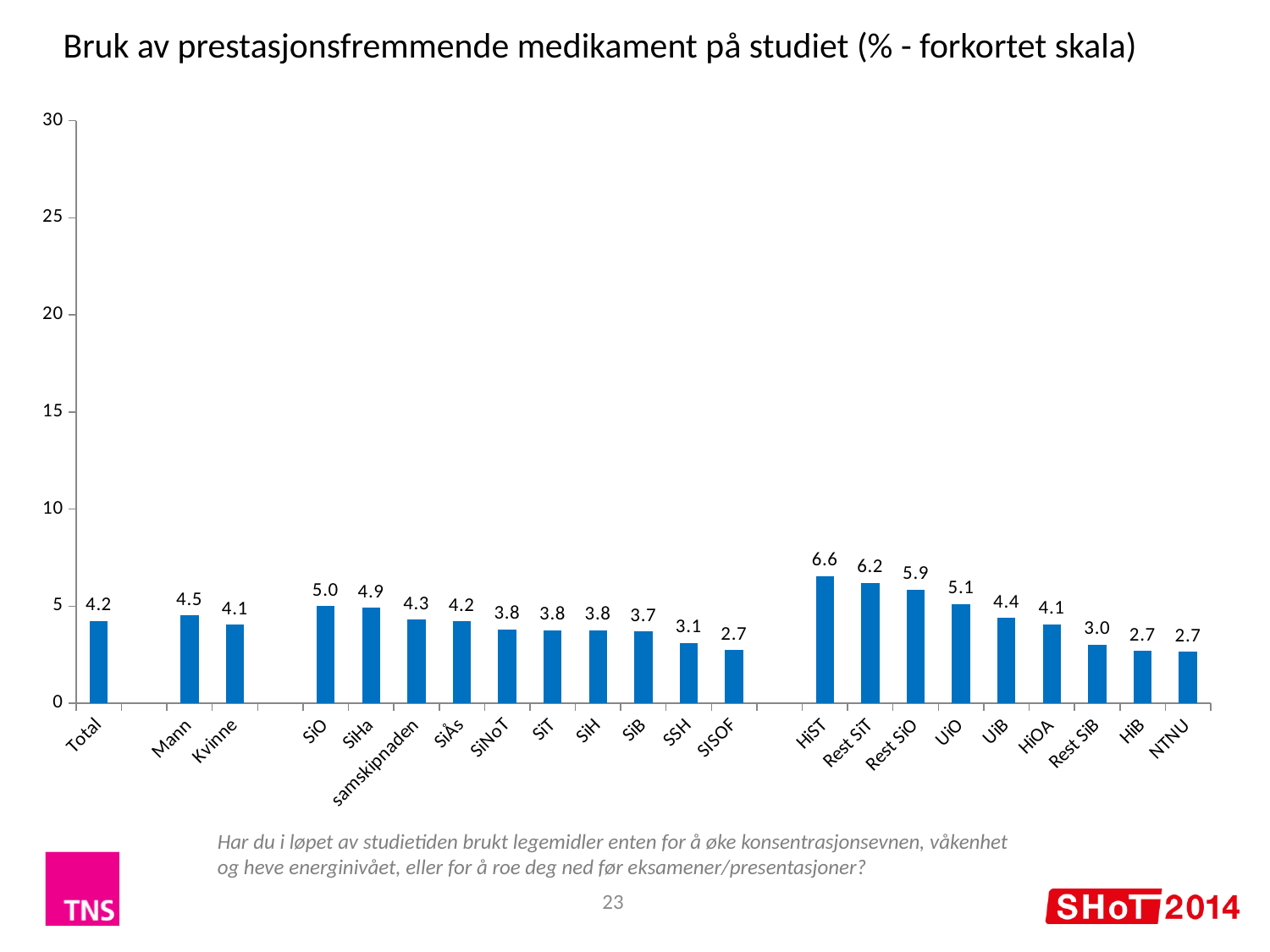
Which category has the highest value? HiST What is the difference between the values for HiST and NTNU? 3.9 What is the value for HiST? 6.6 What is the value for Rest SiB? 3.0 What kind of chart is shown on the slide? Bar chart Which is larger, the value for UiO or the value for UiB? UiO Is the value for Rest SiT greater or less than 5? greater What is the value for Total? 4.2 What is the difference between the values for Mann and Kvinne? 0.4 How many categories are shown on the x axis? 22 Which is larger, the value for SSH or the value for SiHa? SiHa What is the value for SiO? 5.0